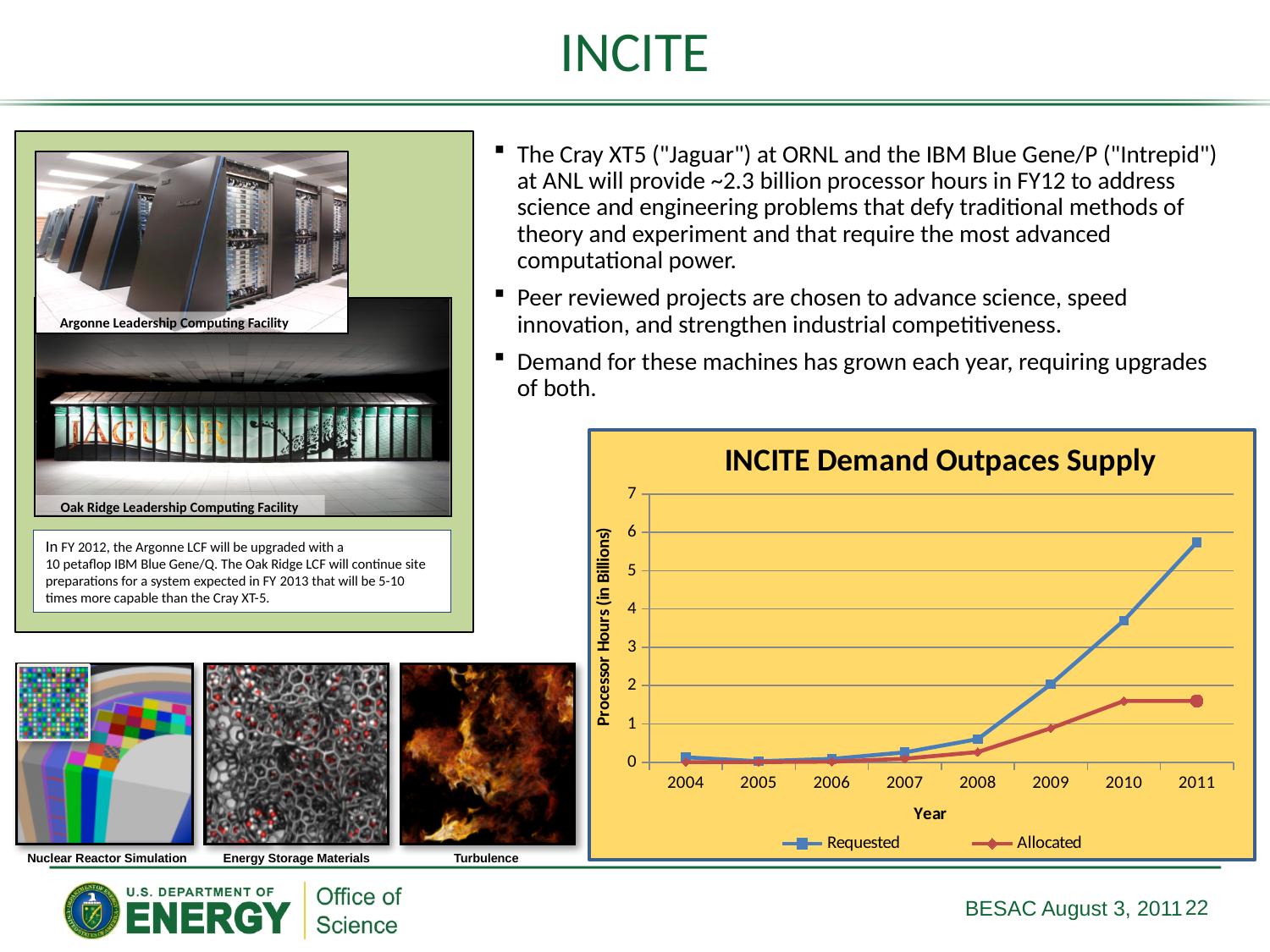
Is the Allocated value for 2011 greater or less than 2? less What are the two series named in the chart's legend? Requested and Allocated How many series does the chart's legend list? 2 What is the title of the chart? INCITE Demand Outpaces Supply Is the Requested value for 2010 greater or less than 3? greater Does the Requested series rise or fall from 2008 to 2011? rise How many years are plotted along the x axis of the chart? 8 Is the Allocated value for 2009 greater or less than 1? less In which year does the Requested series reach its highest value? 2011 What kind of chart is shown on the slide? line chart In 2011, which series has the larger value, Requested or Allocated? Requested